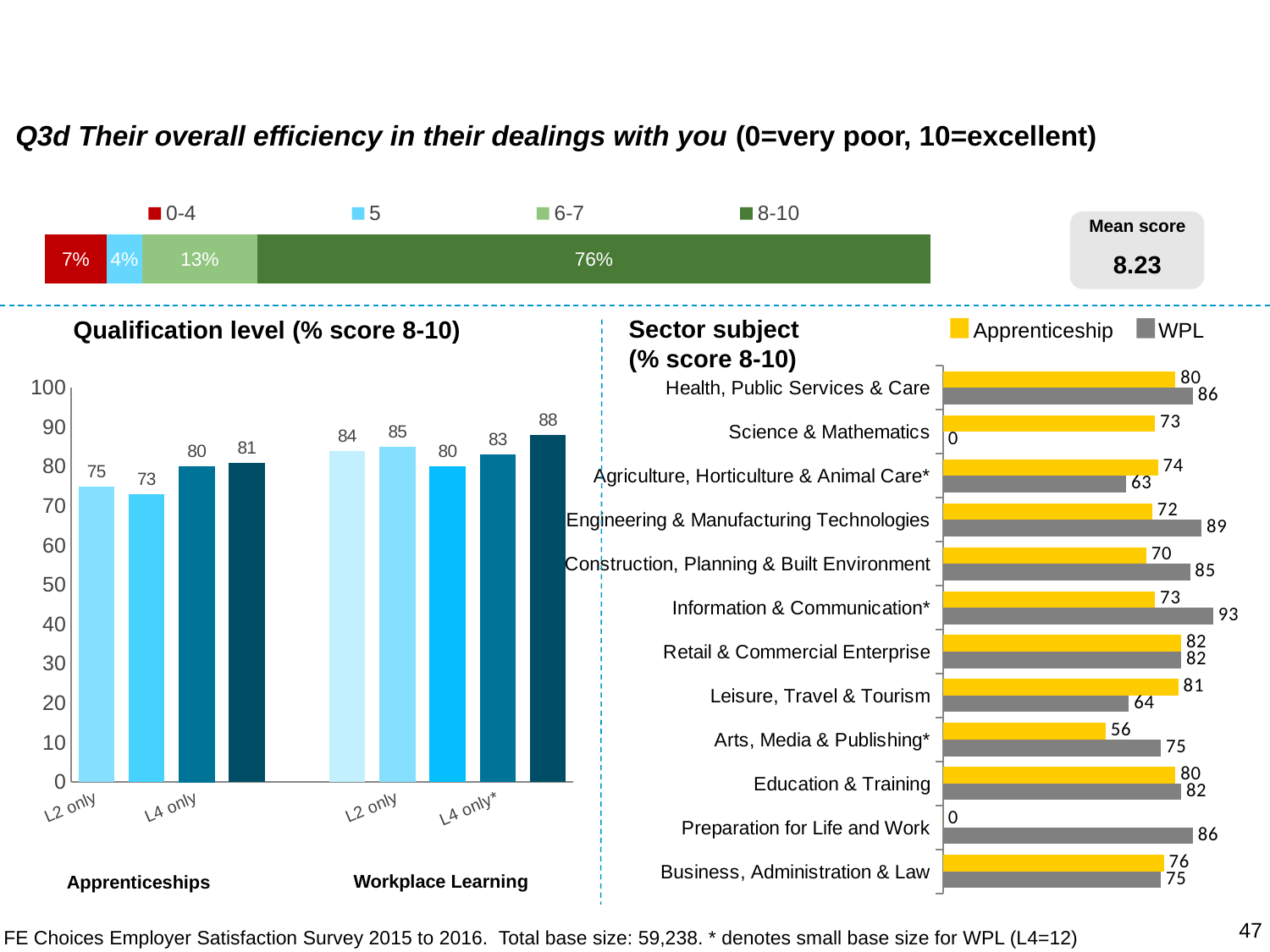
In the 'Sector subject (% score 8-10)' chart, what is the WPL value for Information & Communication*? 93 In the 'Sector subject (% score 8-10)' chart, which sector has the highest WPL value? Information & Communication* What kind of chart is the 'Qualification level (% score 8-10)' chart? bar chart In the 'Qualification level (% score 8-10)' chart, what is the highest value shown? 88 In the top stacked bar chart, what percentage gave a score of 0-4? 7% In the 'Sector subject (% score 8-10)' chart, what is the difference between the WPL and Apprenticeship values for Engineering & Manufacturing Technologies? 17 In the 'Sector subject (% score 8-10)' chart, what is the Apprenticeship value for Arts, Media & Publishing*? 56 In the top stacked bar chart, what percentage of employers gave a score of 8-10? 76% What is the mean score shown on the slide? 8.23 In the 'Sector subject (% score 8-10)' chart, which is larger for Leisure, Travel & Tourism: the Apprenticeship value or the WPL value? Apprenticeship How many score bands does the legend of the top stacked bar chart list? 4 In the 'Qualification level (% score 8-10)' chart, what is the lowest value shown? 73